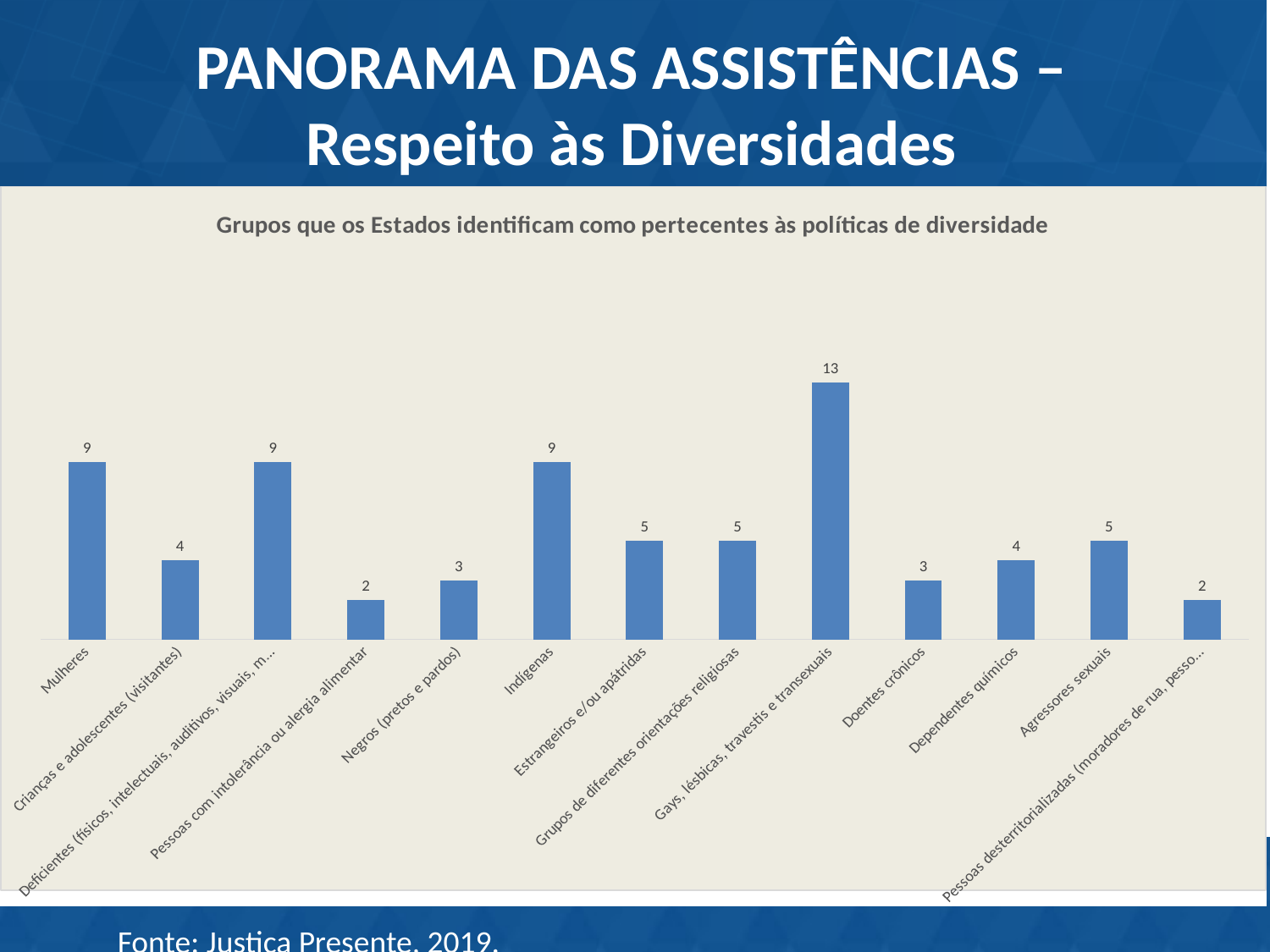
What is the difference between the values for Gays, lésbicas, travestis e transexuais and Mulheres? 4 What is the title of the chart? Grupos que os Estados identificam como pertecentes às políticas de diversidade Which is larger, the value for Crianças e adolescentes (visitantes) or the value for Pessoas com intolerância ou alergia alimentar? Crianças e adolescentes (visitantes) Which category has the highest value? Gays, lésbicas, travestis e transexuais What is the value for Agressores sexuais? 5 What is the difference between the values for Estrangeiros e/ou apátridas and Negros (pretos e pardos)? 2 What is the value for Dependentes químicos? 4 What is the value for Doentes crônicos? 3 What is the value for Mulheres? 9 How many categories are shown in the chart? 13 What kind of chart is shown on the slide? Bar chart What is the value for Indígenas? 9